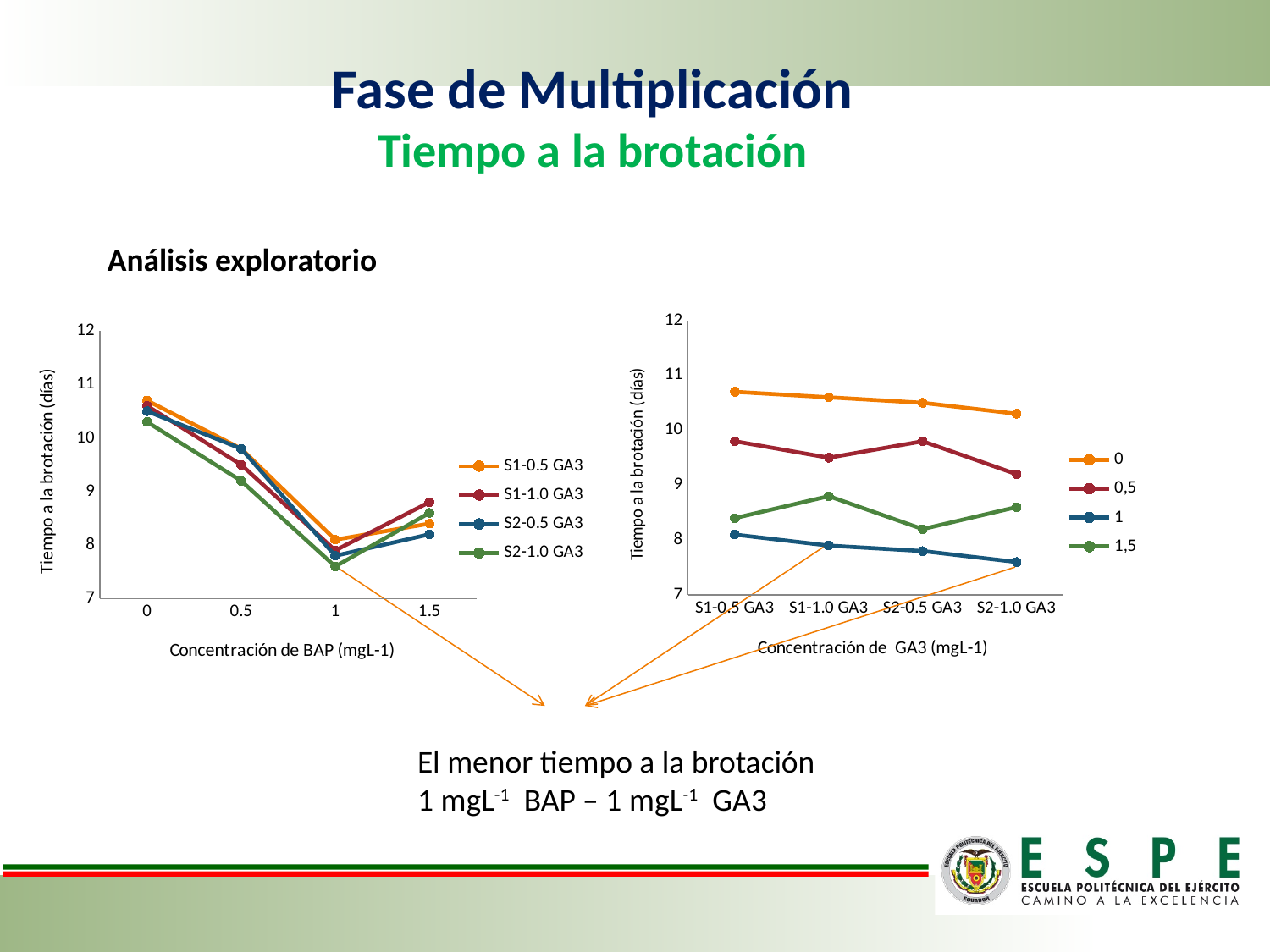
In the left chart (Concentración de BAP), is the value for S2-1.0 GA3 at BAP concentration 1 greater or less than 8? less How many categories are on the x axis of the right chart (Concentración de GA3)? 4 In the left chart (Concentración de BAP), does the S1-1.0 GA3 series rise or fall from BAP concentration 0 to 1? fall In the right chart (Concentración de GA3), which is larger at S2-0.5 GA3: series 0,5 or series 1,5? 0,5 In the right chart (Concentración de GA3), which series has the highest values across all categories? 0 In the left chart (Concentración de BAP), is the value for S1-0.5 GA3 at BAP concentration 0 greater or less than 10? greater How many series does the legend of the left chart (Concentración de BAP) list? 4 In the right chart (Concentración de GA3), is the value of series 1 at S2-1.0 GA3 greater or less than 8? less In the left chart (Concentración de BAP), at which BAP concentration does the S2-1.0 GA3 series reach its lowest value? 1 In the right chart (Concentración de GA3), which series has the lowest values across all categories? 1 In the right chart (Concentración de GA3), does series 0 rise or fall from S1-0.5 GA3 to S2-1.0 GA3? fall What kind of chart is the left chart (Concentración de BAP)? line chart